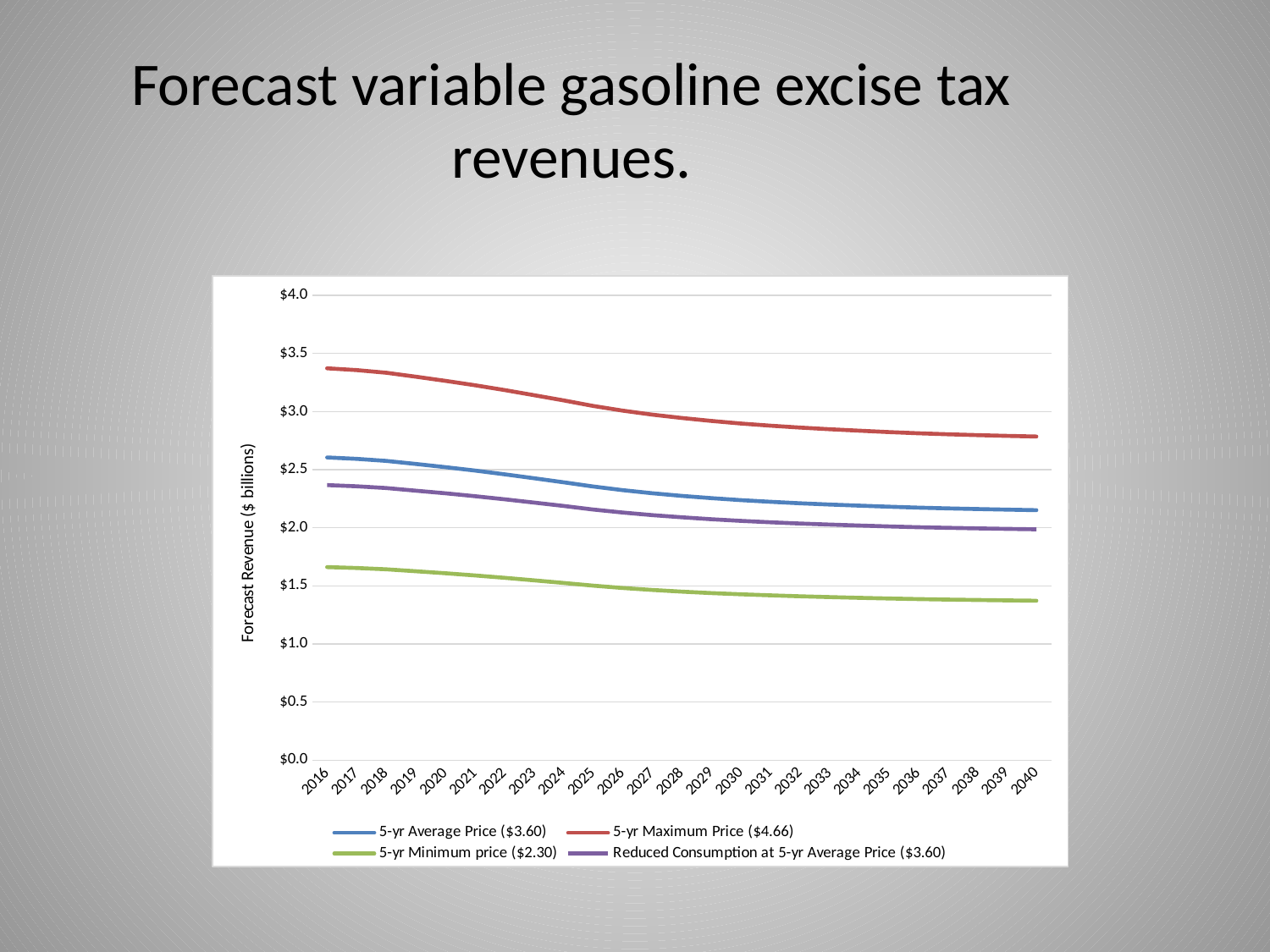
In 2016, which is higher: 5-yr Average Price ($3.60) or Reduced Consumption at 5-yr Average Price ($3.60)? 5-yr Average Price ($3.60) Which series has the highest forecast revenue across all years? 5-yr Maximum Price ($4.66) Is the value for 5-yr Maximum Price ($4.66) in 2016 greater or less than $3.0? greater Do the forecast revenues for the 5-yr Average Price ($3.60) series rise or fall from 2016 to 2040? fall How many years are plotted along the x axis? 25 Is the value for Reduced Consumption at 5-yr Average Price ($3.60) in 2016 greater or less than $2.0? greater How many series does the legend list? 4 Is the value for 5-yr Maximum Price ($4.66) in 2040 greater or less than $3.0? less What is the label on the vertical axis of the chart? Forecast Revenue ($ billions) What kind of chart is shown on the slide? line chart Which series has the lowest forecast revenue across all years? 5-yr Minimum price ($2.30)